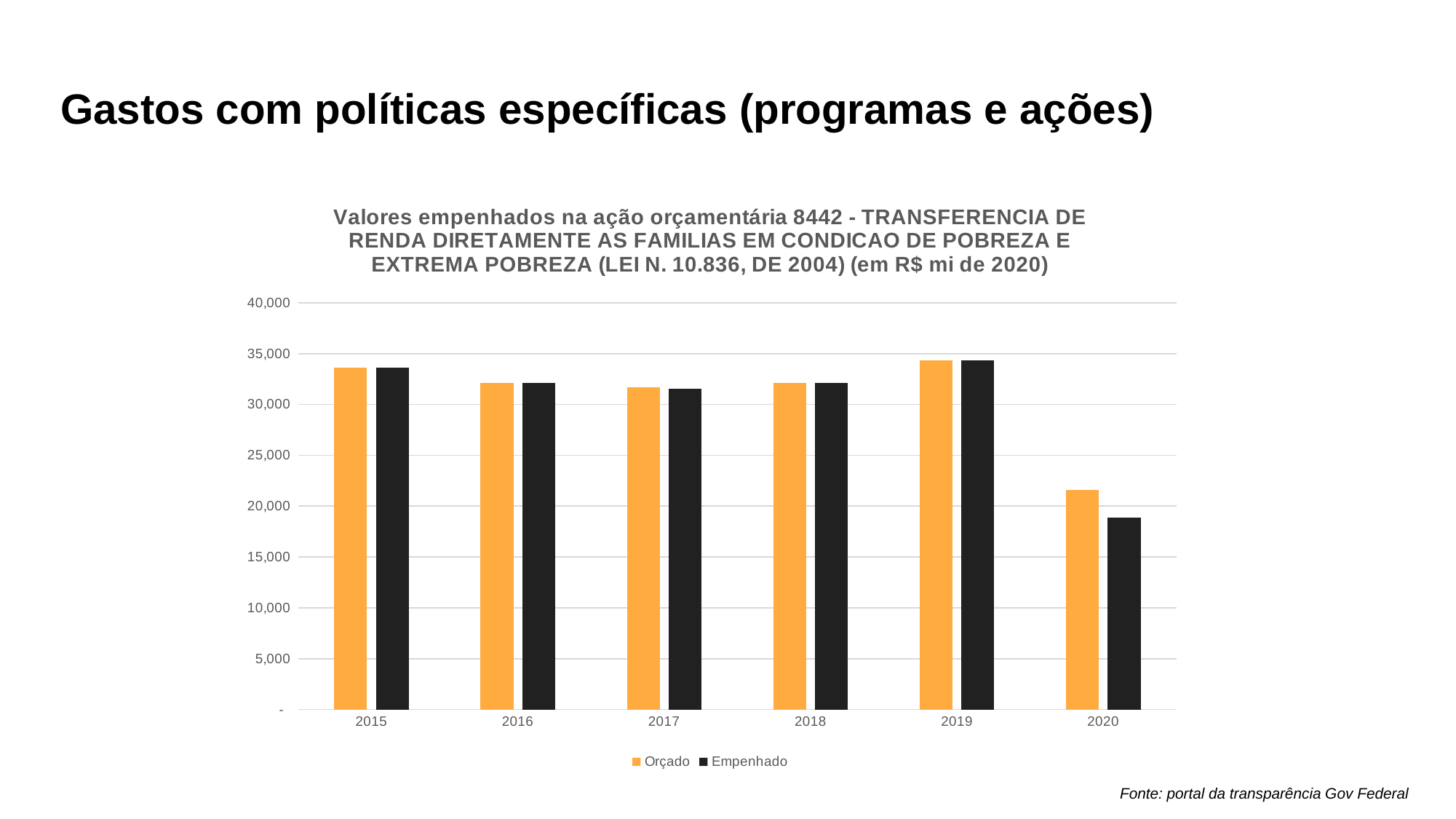
Which year has the highest Empenhado value? 2019 What colour are the Orçado bars? orange Is the Orçado value for 2020 greater or less than 20,000? greater How many series does the legend list? 2 What kind of chart is shown on the slide? bar chart How many years are shown on the x axis? 6 Is the Empenhado value for 2020 greater or less than 20,000? less Is the Empenhado value for 2019 greater or less than 35,000? less Does the Empenhado value rise or fall from 2019 to 2020? fall In 2020, which is larger, Orçado or Empenhado? Orçado Which year has the lowest Orçado value? 2020